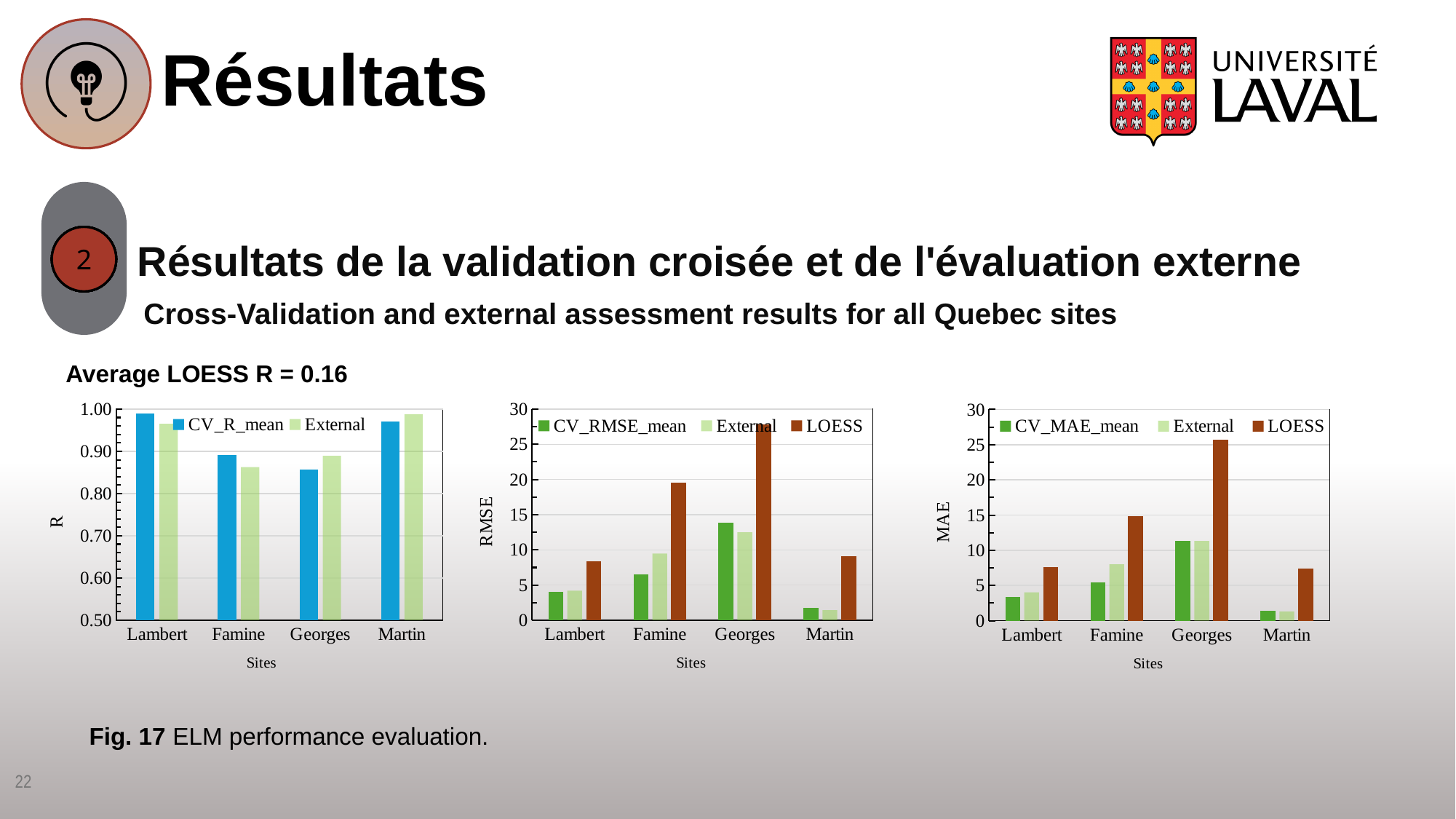
In the middle chart (RMSE), how many series does the legend list? 3 What kind of chart is the right chart (MAE)? bar chart In the right chart (MAE), which site has the lowest CV_MAE_mean value? Martin In the left chart (R), is the CV_R_mean value for Georges greater or less than 0.90? less In the left chart (R), how many series does the legend list? 2 In the right chart (MAE), is the LOESS value for Famine greater or less than 10? greater In the middle chart (RMSE), how many sites are shown on the x axis? 4 In the middle chart (RMSE), which site has the highest LOESS value? Georges What is the y-axis label of the left chart? R In the middle chart (RMSE), is the LOESS value for Georges greater or less than 25? greater In the left chart (R), which is larger for Lambert, CV_R_mean or External? CV_R_mean In the middle chart (RMSE), which is larger for Famine, External or LOESS? LOESS